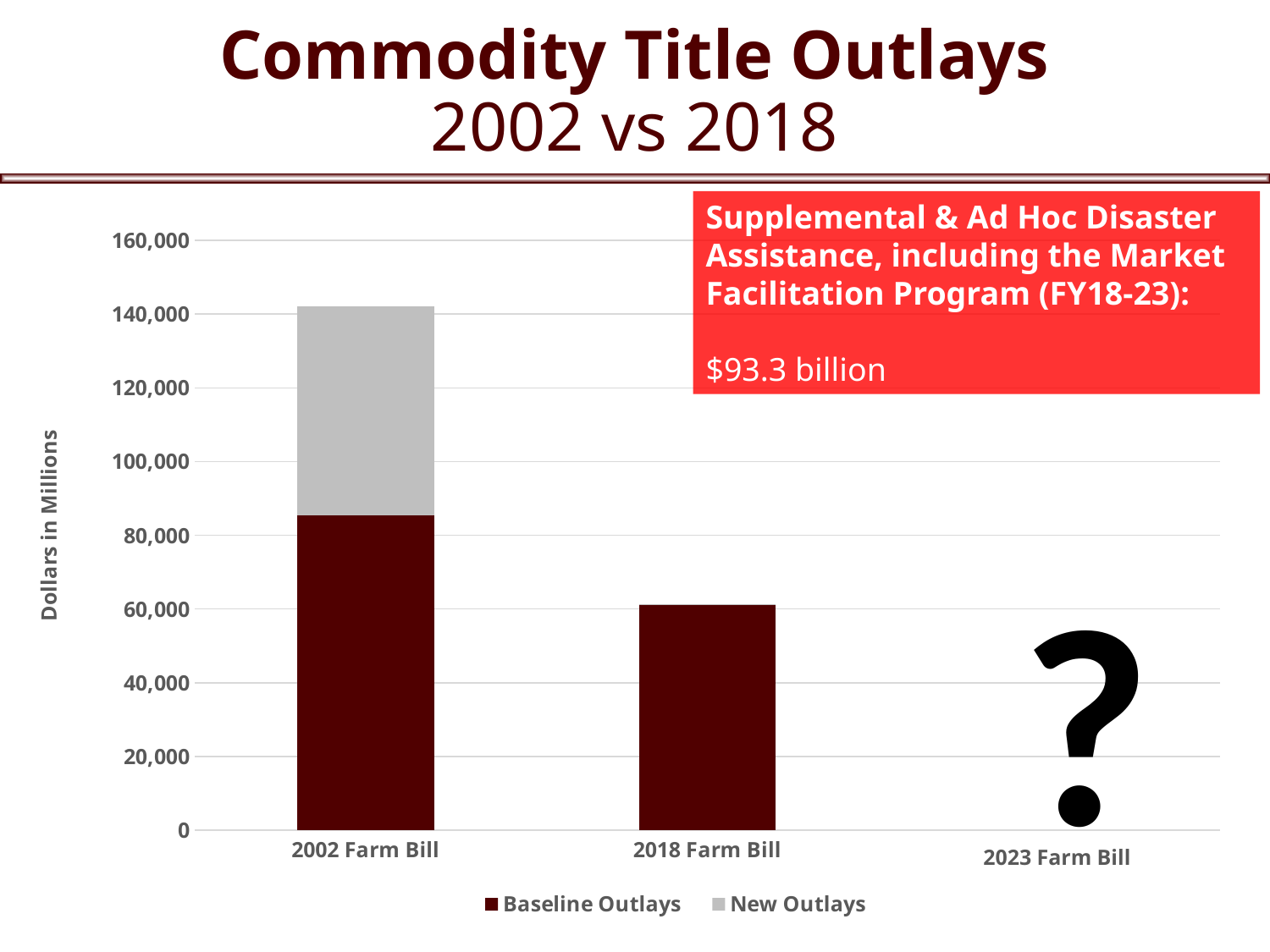
Which category shows a question mark instead of a bar? 2023 Farm Bill Is the Baseline Outlays value for the 2018 Farm Bill greater or less than 80,000? less How many categories are shown on the x axis? 3 Is the Baseline Outlays value for the 2018 Farm Bill greater or less than 40,000? greater What is the label on the y axis? Dollars in Millions Which category has the tallest bar? 2002 Farm Bill Is the total height of the 2002 Farm Bill bar greater or less than 140,000? greater How many series does the legend list? 2 What kind of chart is shown on the slide? bar chart Which farm bill has the larger Baseline Outlays, 2002 or 2018? 2002 Farm Bill Do the Baseline Outlays values rise or fall from the 2002 Farm Bill to the 2018 Farm Bill? fall